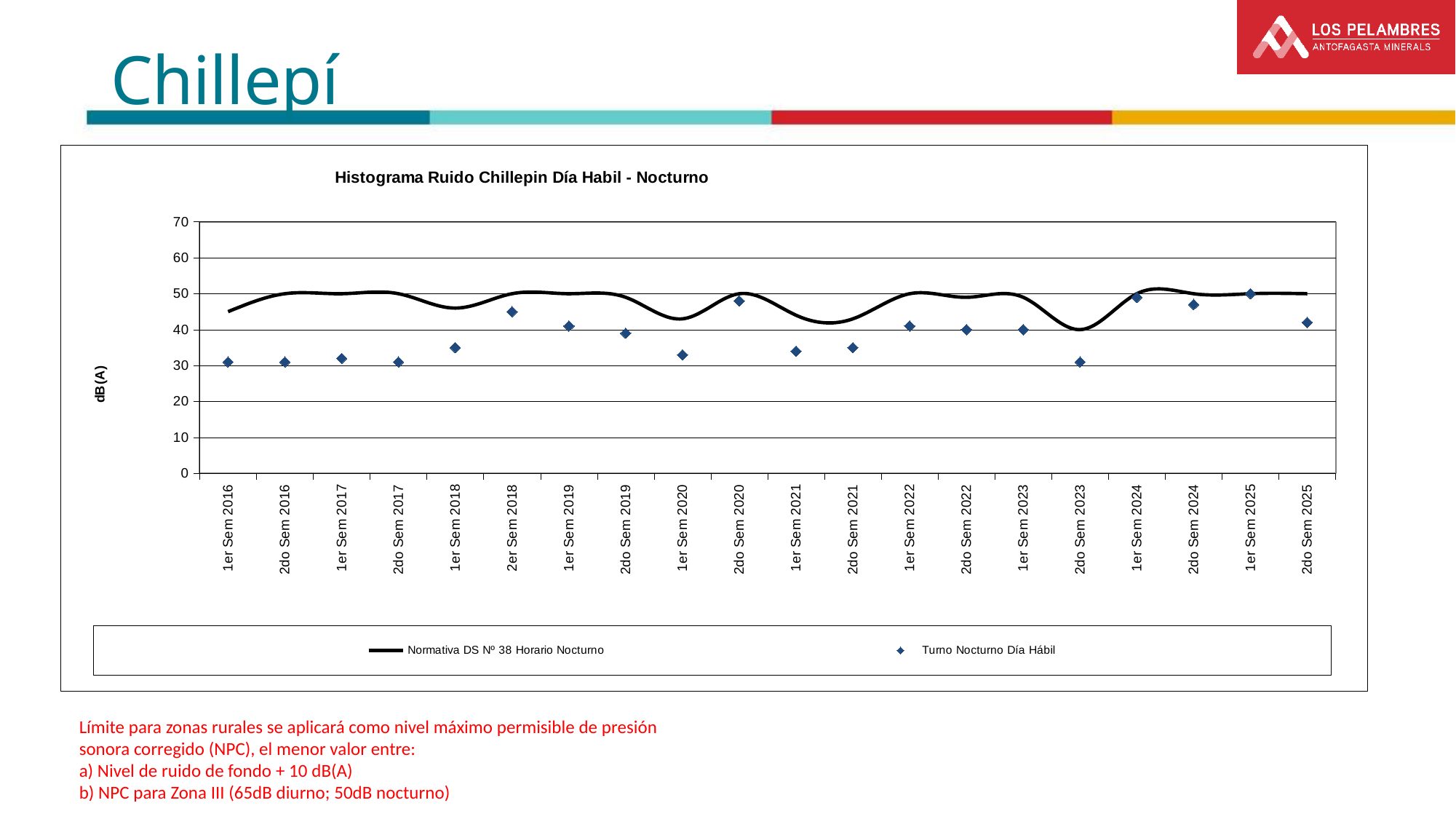
Is the Turno Nocturno Día Hábil value for 1er Sem 2024 greater or less than 40? greater How many series does the chart legend list? 2 Is the Turno Nocturno Día Hábil value for 2do Sem 2023 greater or less than 40? less What is the label of the y axis? dB(A) Which has the higher Turno Nocturno Día Hábil value, 1er Sem 2018 or 2er Sem 2018? 2er Sem 2018 What is the title of the chart? Histograma Ruido Chillepin Día Habil - Nocturno Which has the higher Turno Nocturno Día Hábil value, 2do Sem 2020 or 1er Sem 2021? 2do Sem 2020 How many semester categories are shown on the x axis? 20 Is the Turno Nocturno Día Hábil value for 1er Sem 2016 greater or less than 40? less Do the Turno Nocturno Día Hábil values rise or fall from 1er Sem 2016 to 2er Sem 2018? rise What kind of chart is this? line chart